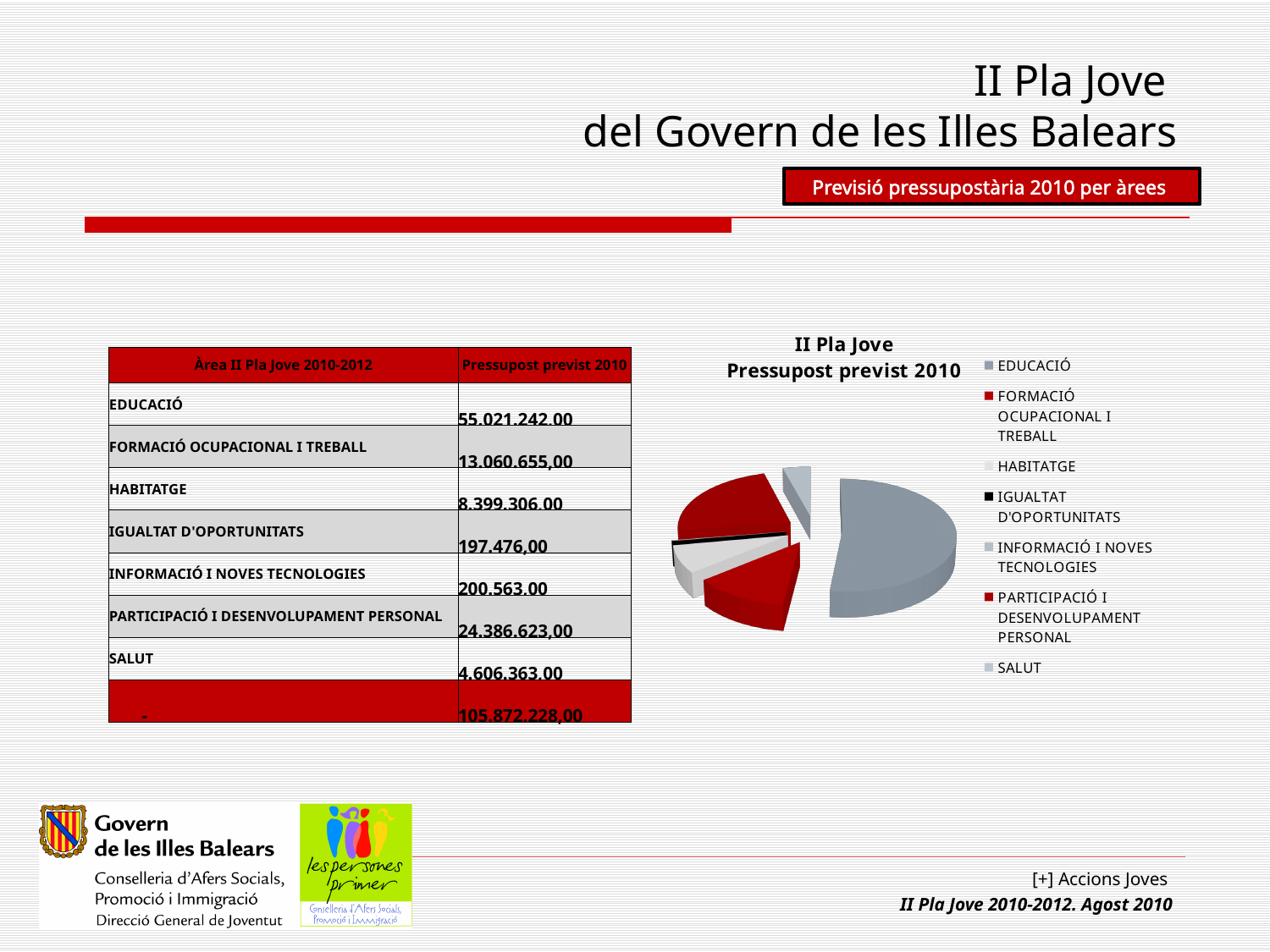
Which is larger in the pie chart, the slice for PARTICIPACIÓ I DESENVOLUPAMENT PERSONAL or the slice for HABITATGE? PARTICIPACIÓ I DESENVOLUPAMENT PERSONAL How many slices does the pie chart have? 7 According to the table next to the pie chart, what is the Pressupost previst 2010 for FORMACIÓ OCUPACIONAL I TREBALL? 13.060.655,00 According to the table next to the pie chart, what is the total Pressupost previst 2010 across all areas? 105.872.228,00 Which is larger in the pie chart, the slice for EDUCACIÓ or the slice for SALUT? EDUCACIÓ According to the table next to the pie chart, what is the Pressupost previst 2010 for SALUT? 4.606.363,00 What colour is the slice for FORMACIÓ OCUPACIONAL I TREBALL in the pie chart? red What kind of chart is shown on the slide? pie chart What is the title of the pie chart? II Pla Jove Pressupost previst 2010 According to the table next to the pie chart, what is the Pressupost previst 2010 for EDUCACIÓ? 55.021.242,00 How many categories does the legend of the pie chart list? 7 Which category has the largest slice in the pie chart? EDUCACIÓ